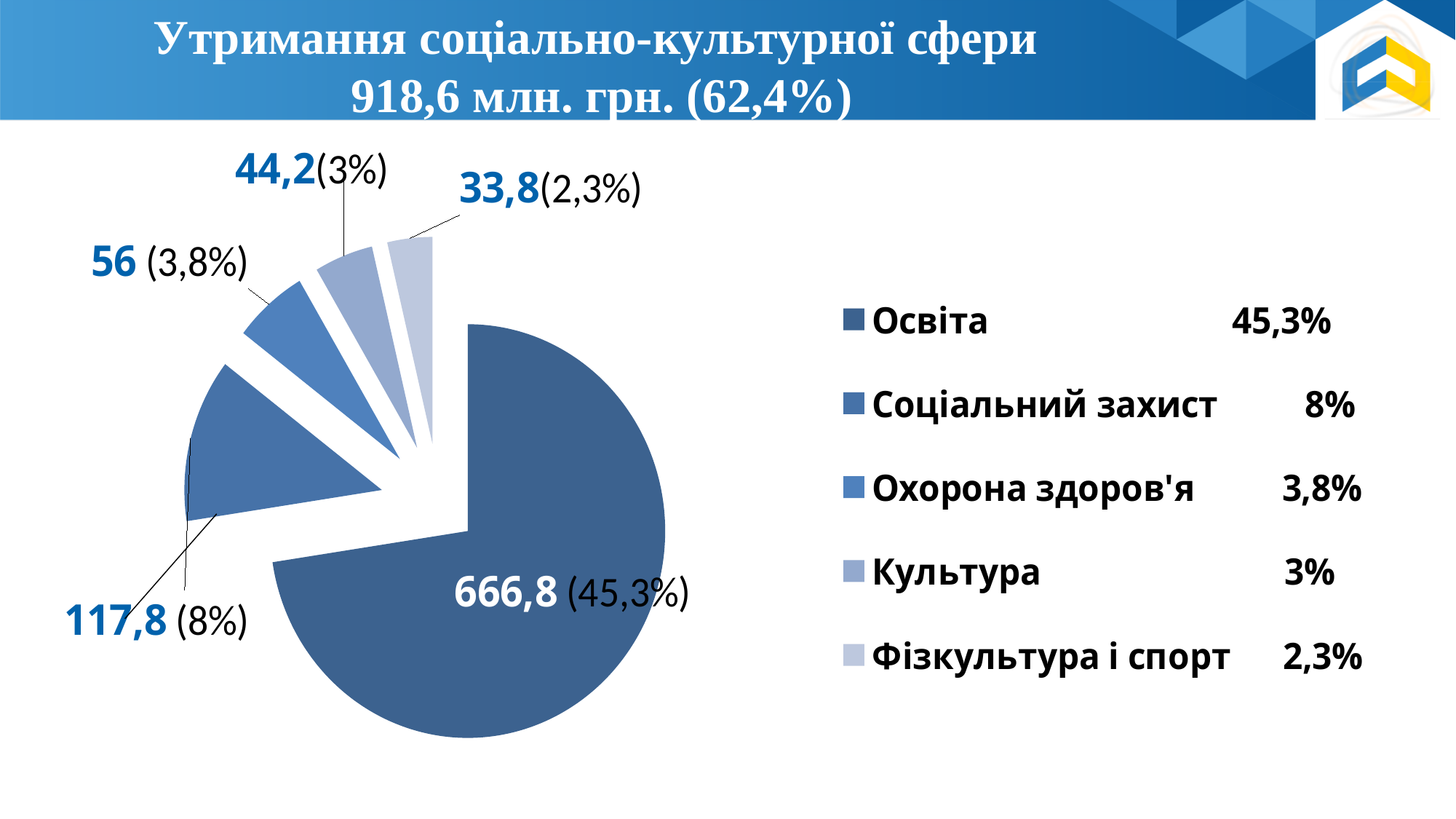
Which category has the smallest slice? Фізкультура і спорт What kind of chart is shown on the slide? pie chart What share of the pie does Освіта represent? 45,3% What is the value for Охорона здоров'я? 56 What is the difference between the values for Освіта and Соціальний захист? 549 What is the value for Фізкультура і спорт? 33,8 Which is larger, the value for Охорона здоров'я or the value for Культура? Охорона здоров'я What is the value for Соціальний захист? 117,8 What is the value for Освіта? 666,8 How many slices does the pie chart have? 5 Which category has the largest slice? Освіта What share of the pie does Культура represent? 3%